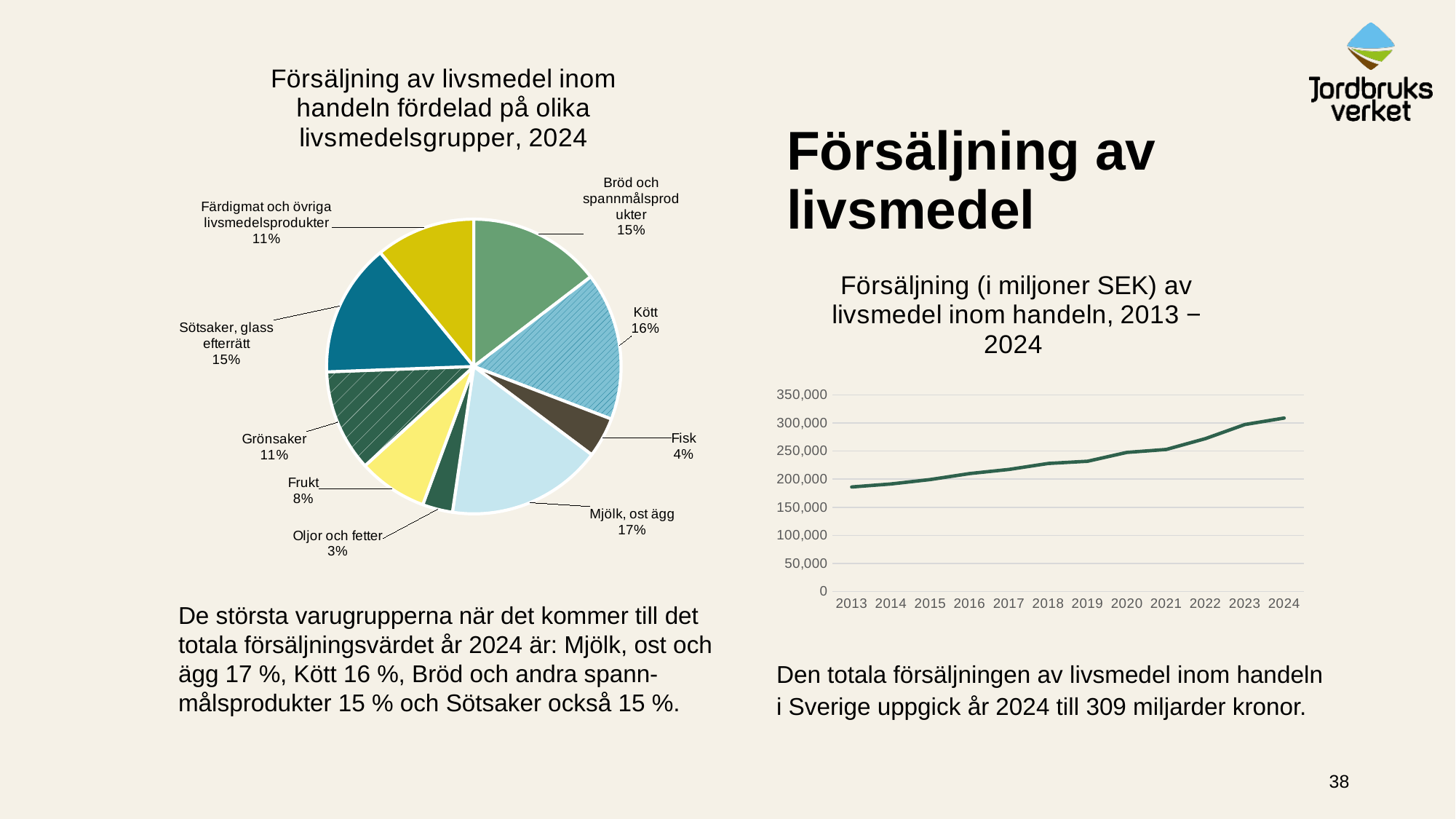
In the pie chart on the left, which category has the largest share? Mjölk, ost ägg In the line chart on the right, is the value for 2024 greater or less than 300,000? greater How many slices does the pie chart on the left have? 9 In the pie chart on the left, which is larger: Grönsaker or Frukt? Grönsaker In the line chart on the right, do the values rise or fall from 2013 to 2024? Rise In the pie chart on the left, what share does Fisk have? 4% What kind of chart is the chart on the right of the slide? Line chart In the pie chart on the left, what is the difference in percentage points between Kött and Frukt? 8 In the pie chart on the left, which category has the smallest share? Oljor och fetter In the pie chart on the left, what share does Mjölk, ost ägg have? 17% In the line chart on the right, is the value for 2013 greater or less than 200,000? less How many years are shown on the x axis of the line chart on the right? 12